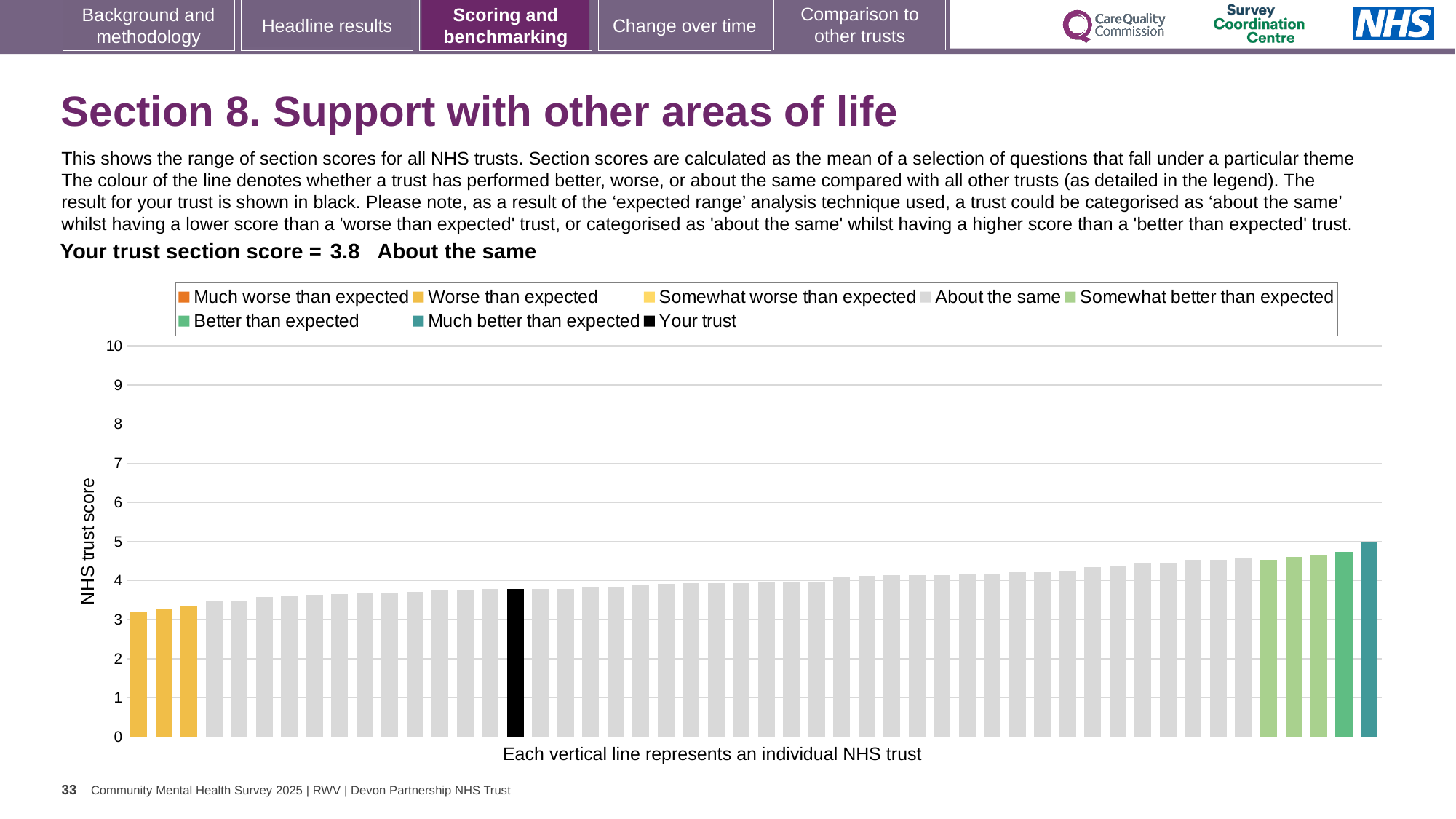
What kind of chart is shown on the slide? bar chart How many bars are coloured as 'Worse than expected' (yellow)? 3 What is the section score for your trust shown on the slide? 3.8 Which bar is taller, the leftmost bar or the rightmost bar? the rightmost bar Do the bar values rise or fall from left to right along the x axis? rise What is the highest value shown on the vertical axis? 10 Is the value of the leftmost bar greater or less than 3? greater Is the value of the black bar for your trust greater or less than 4? less Which category is your trust placed in for this section? About the same How many entries does the chart legend list? 8 What is the label of the vertical axis? NHS trust score Is the value of the leftmost bar greater or less than 4? less